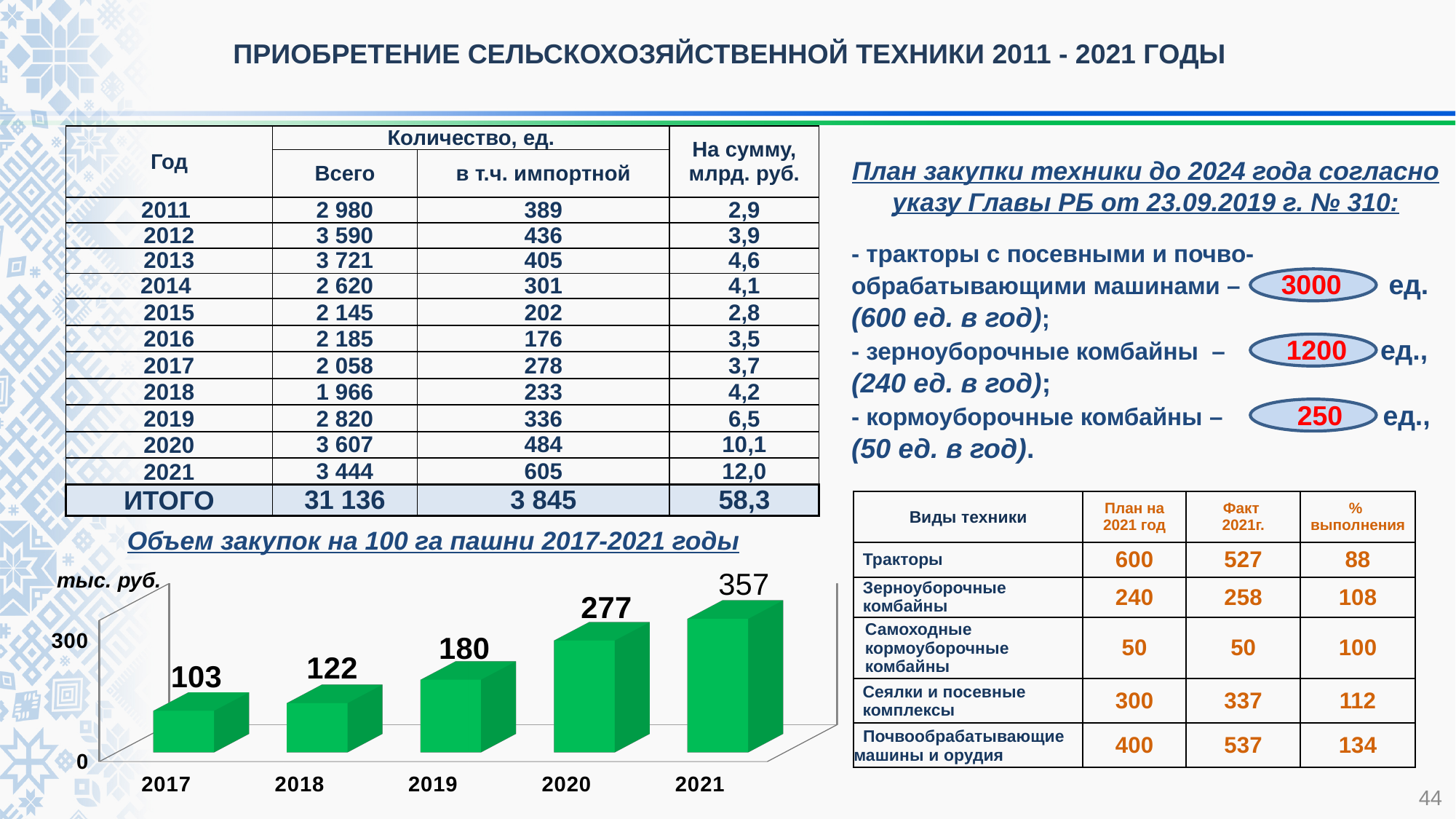
How many years are shown in the chart 'Объем закупок на 100 га пашни 2017-2021 годы'? 5 Do the values in the chart 'Объем закупок на 100 га пашни 2017-2021 годы' rise or fall from 2017 to 2021? rise What is the value for 2017 in the chart 'Объем закупок на 100 га пашни 2017-2021 годы'? 103 In the chart 'Объем закупок на 100 га пашни 2017-2021 годы', what is the difference between the values for 2018 and 2017? 19 Which year has the highest value in the chart 'Объем закупок на 100 га пашни 2017-2021 годы'? 2021 What kind of chart is 'Объем закупок на 100 га пашни 2017-2021 годы'? bar chart Which year has the lowest value in the chart 'Объем закупок на 100 га пашни 2017-2021 годы'? 2017 In the chart 'Объем закупок на 100 га пашни 2017-2021 годы', which is larger, the value for 2019 or the value for 2020? 2020 In the chart 'Объем закупок на 100 га пашни 2017-2021 годы', is the value for 2020 greater or less than 300? less What is the value for 2019 in the chart 'Объем закупок на 100 га пашни 2017-2021 годы'? 180 What is the value for 2021 in the chart 'Объем закупок на 100 га пашни 2017-2021 годы'? 357 In the chart 'Объем закупок на 100 га пашни 2017-2021 годы', what is the difference between the values for 2021 and 2020? 80